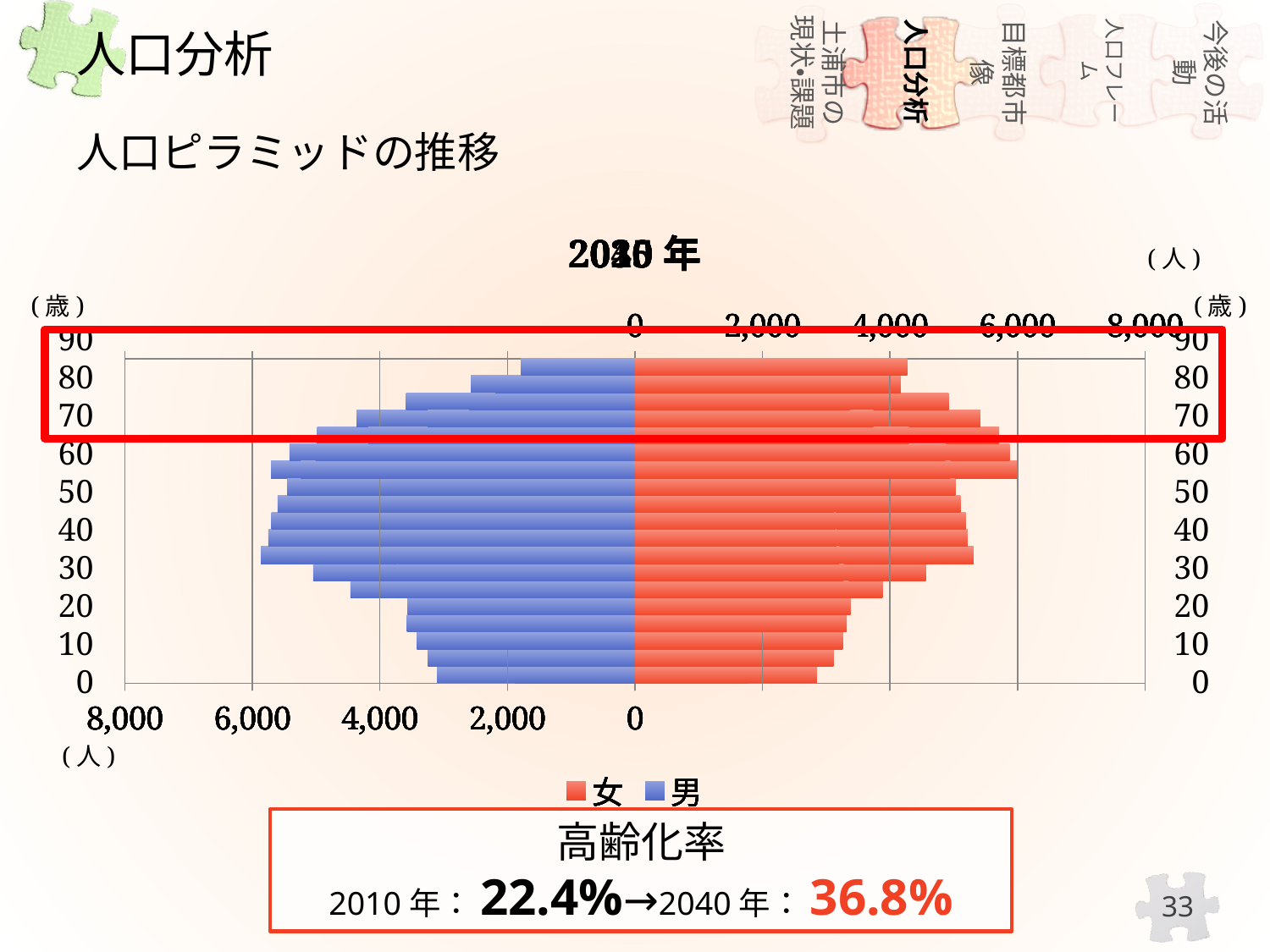
Is the value for 男 at age 60 greater or less than 4,000? greater Is the value for 女 at age 70 greater or less than 4,000? greater At age 40, which is larger, the value for 男 or the value for 女? 男 How many series does the legend list? 2 Is the value for 女 at age 10 greater or less than 4,000? less Which series is shown in red in the legend? 女 What is the largest value shown on the horizontal axis? 8,000 What kind of chart is shown on the slide? bar chart